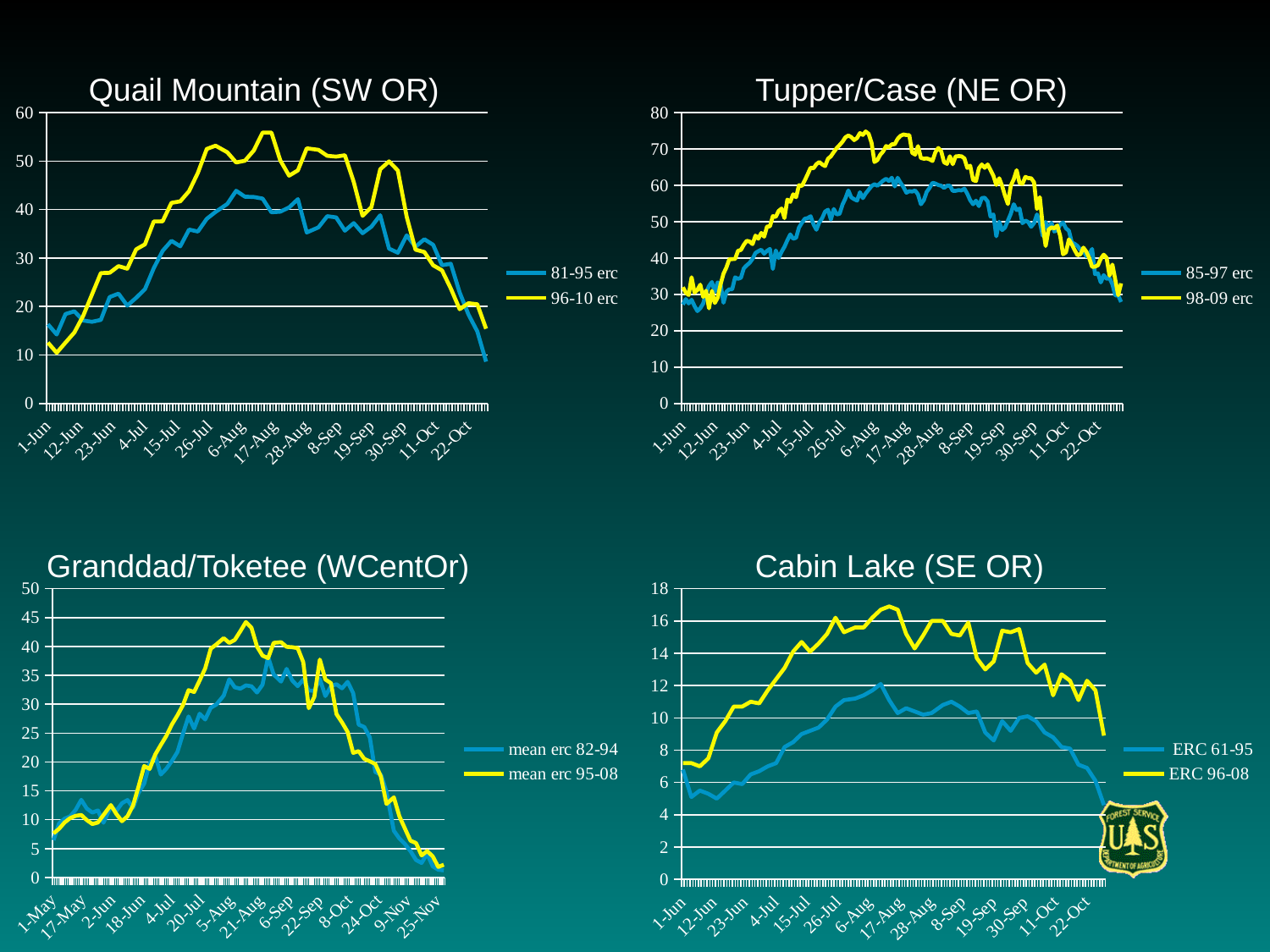
On the Tupper/Case (NE OR) chart, is the peak value of the 98-09 erc series greater or less than 70? greater On the Tupper/Case (NE OR) chart, which series is higher around 6-Aug, 85-97 erc or 98-09 erc? 98-09 erc What kind of chart is the Quail Mountain (SW OR) chart? line chart On the Tupper/Case (NE OR) chart, does the 98-09 erc series rise or fall from 17-Aug to 22-Oct? fall On the Quail Mountain (SW OR) chart, is the peak value of the 96-10 erc series greater or less than 50? greater On the Quail Mountain (SW OR) chart, does the 96-10 erc series rise or fall from 1-Jun to 6-Aug? rise What are the two legend entries on the Quail Mountain (SW OR) chart? 81-95 erc and 96-10 erc What are the two legend entries on the Granddad/Toketee (WCentOr) chart? mean erc 82-94 and mean erc 95-08 How many series does the legend of the Cabin Lake (SE OR) chart list? 2 On the Granddad/Toketee (WCentOr) chart, which series is higher around 21-Aug, mean erc 82-94 or mean erc 95-08? mean erc 95-08 On the Cabin Lake (SE OR) chart, is the peak value of the ERC 96-08 series greater or less than 16? greater How many series does the legend of the Quail Mountain (SW OR) chart list? 2